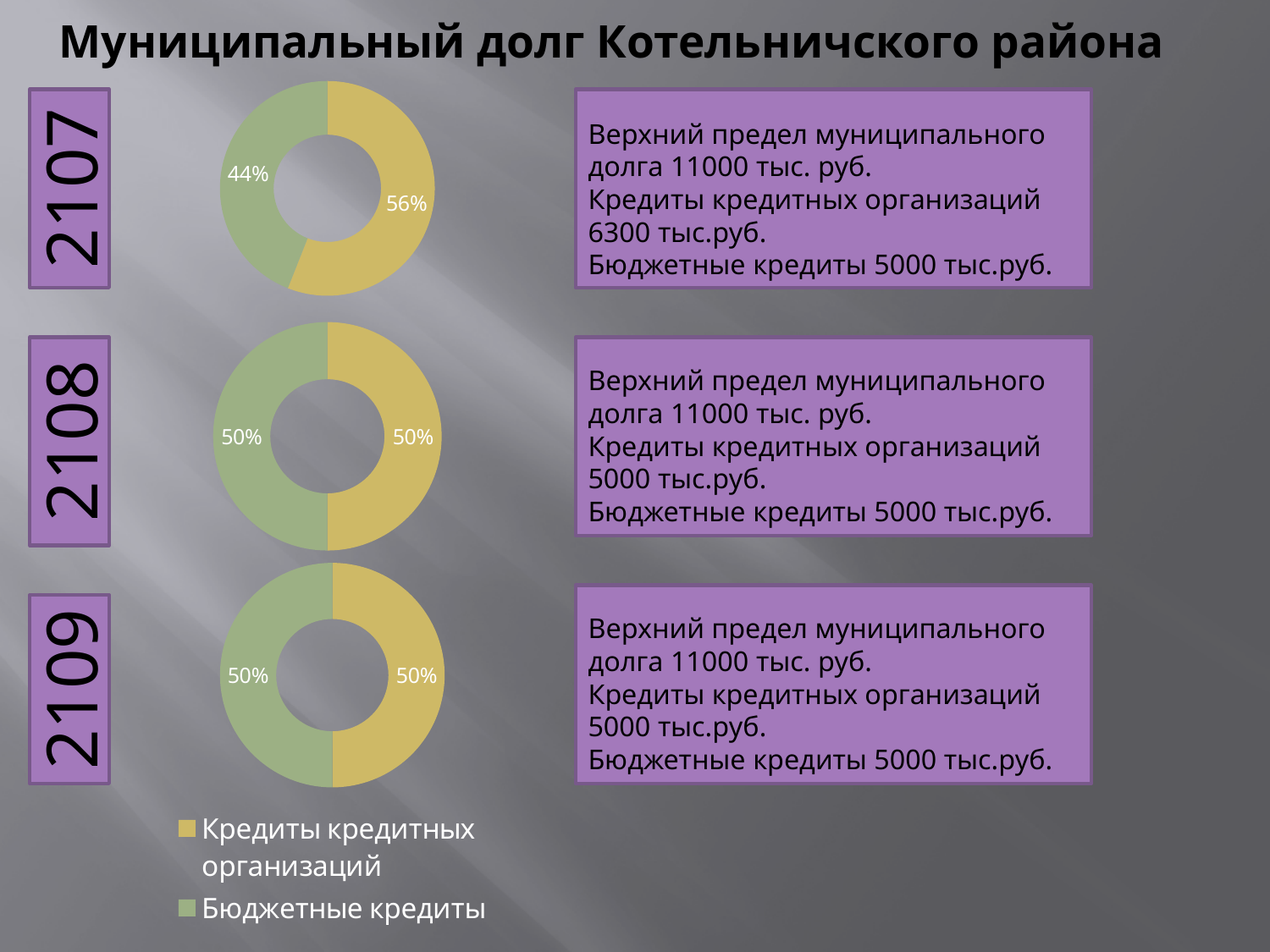
What is the title of the slide? Муниципальный долг Котельничского района In the top chart (labelled 2107), which slice is larger: Кредиты кредитных организаций or Бюджетные кредиты? Кредиты кредитных организаций In the top chart (labelled 2107), what is the difference in percentage points between the two slices? 12 In the top chart (labelled 2107), what share is shown for Кредиты кредитных организаций? 56% What kind of chart is used for each of the three charts on the slide? Doughnut (pie) chart In the bottom chart (labelled 2109), what share is shown for Кредиты кредитных организаций? 50% How many slices does the top chart (labelled 2107) have? 2 In the top chart (labelled 2107), what share is shown for Бюджетные кредиты? 44% How many entries does the shared legend list? 2 Which legend entry is shown in green? Бюджетные кредиты How many doughnut charts are on the slide? 3